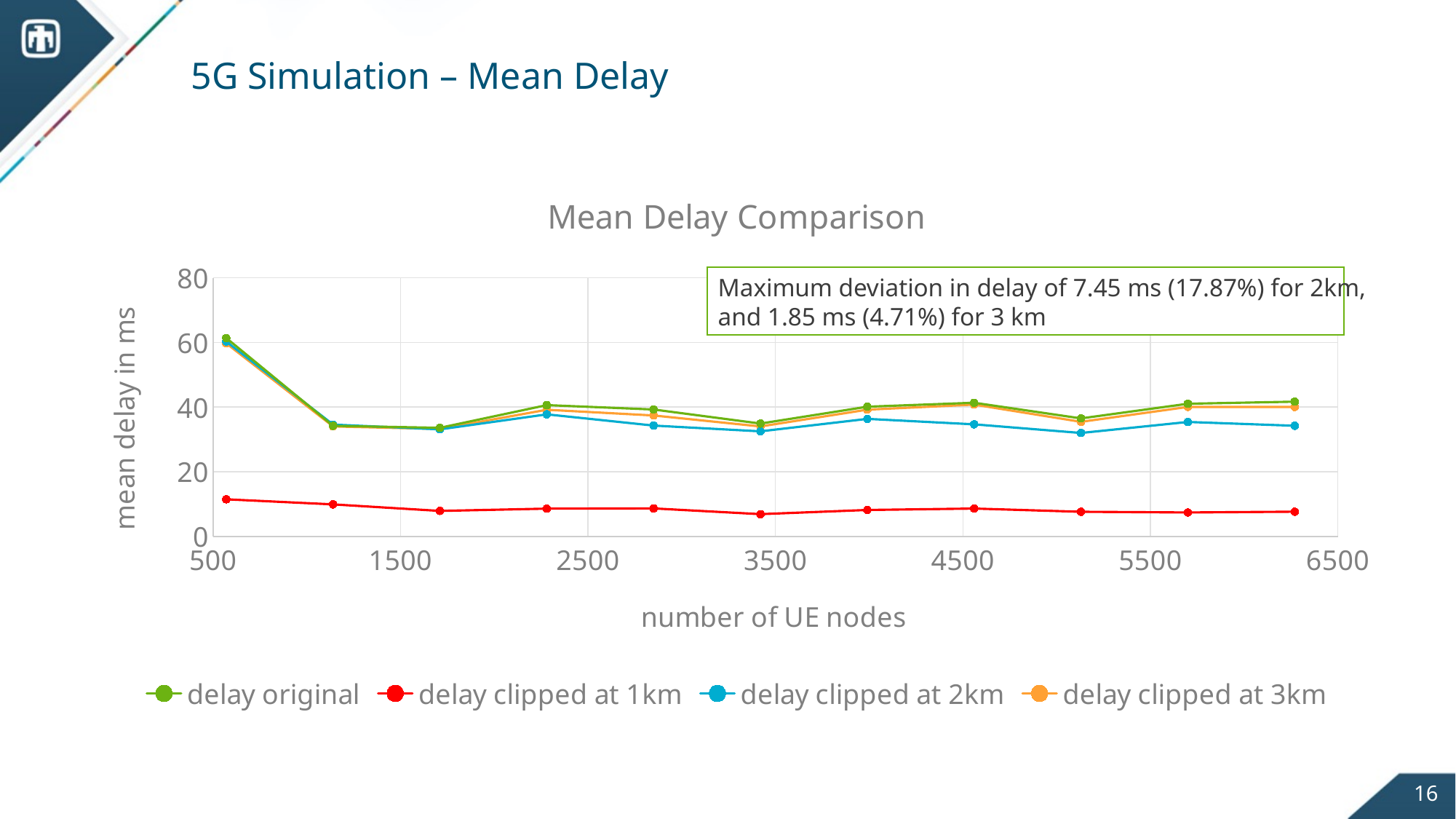
Is the value for delay clipped at 1km at the first data point (around 500 UE nodes) greater or less than 20? less Does the delay original series rise or fall between the first and second data points? fall Is the value for delay original at the first data point (around 500 UE nodes) greater or less than 40? greater According to the annotation on the chart, what is the maximum deviation in delay for 2km? 7.45 ms (17.87%) What kind of chart is shown on the slide? line chart Is the value for delay clipped at 2km at around 5100 UE nodes greater or less than 40? less How many data points are plotted for the delay clipped at 1km series? 11 At around 3500 UE nodes, which is larger: delay original or delay clipped at 1km? delay original How many series does the legend of the Mean Delay Comparison chart list? 4 What is the title of the chart on the slide? Mean Delay Comparison Which series has the lowest mean delay across all numbers of UE nodes? delay clipped at 1km